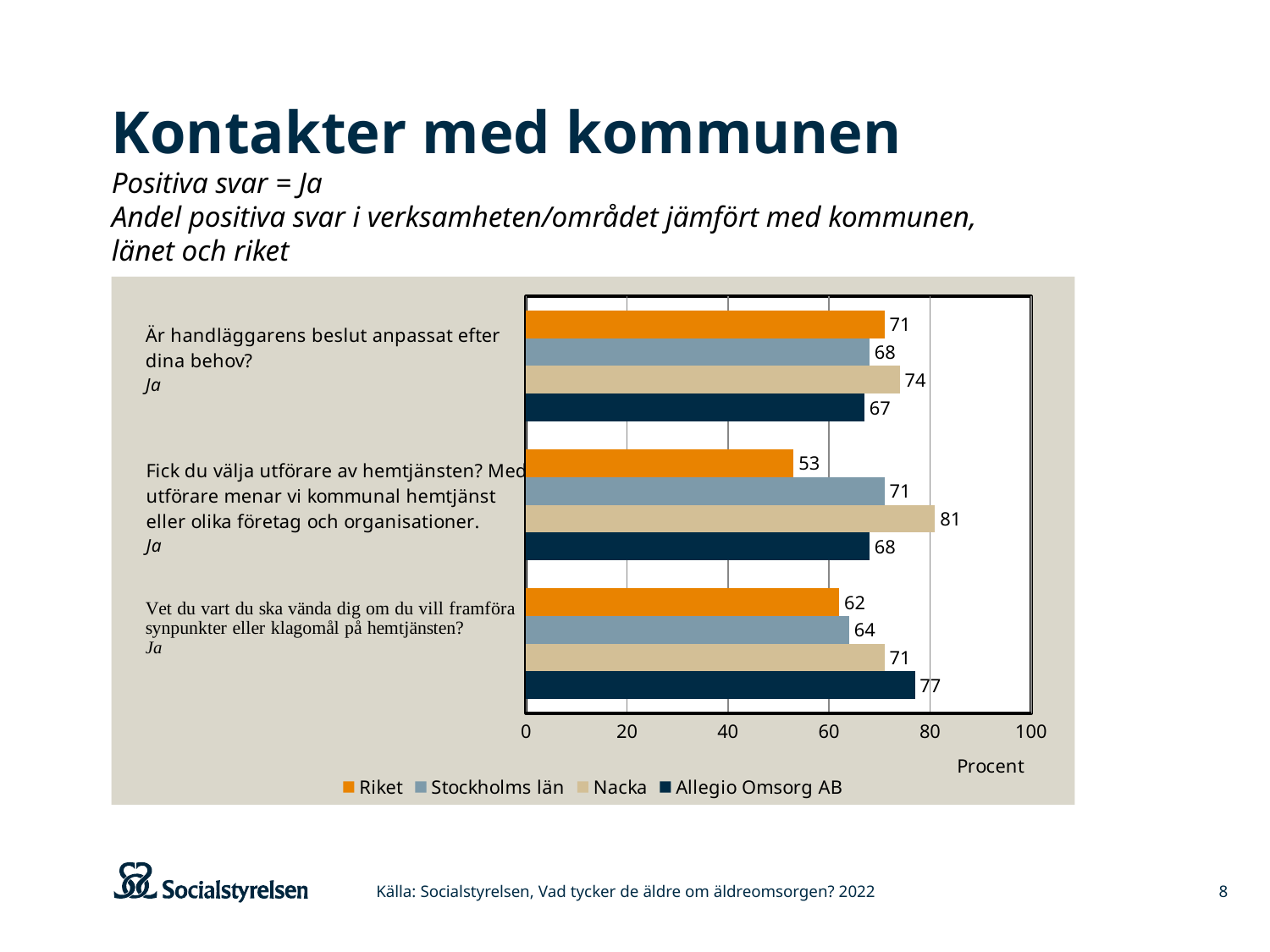
What kind of chart is shown on the slide? Bar chart Which series has the lowest value on the question "Fick du välja utförare av hemtjänsten?"? Riket What is the difference between Nacka and Riket on the question "Fick du välja utförare av hemtjänsten?"? 28 How many question categories are plotted on the chart? 3 What is the value for Allegio Omsorg AB on the question "Vet du vart du ska vända dig om du vill framföra synpunkter eller klagomål på hemtjänsten?"? 77 What is the value for Nacka on the question "Fick du välja utförare av hemtjänsten?"? 81 Which series has the highest value on the question "Fick du välja utförare av hemtjänsten?"? Nacka What is the value for Riket on the question "Är handläggarens beslut anpassat efter dina behov?"? 71 On the question "Är handläggarens beslut anpassat efter dina behov?", which is larger: Stockholms län or Allegio Omsorg AB? Stockholms län What unit is shown on the x axis of the chart? Procent Is the value for Riket on the question "Fick du välja utförare av hemtjänsten?" greater or less than 60? less How many series does the legend list? 4